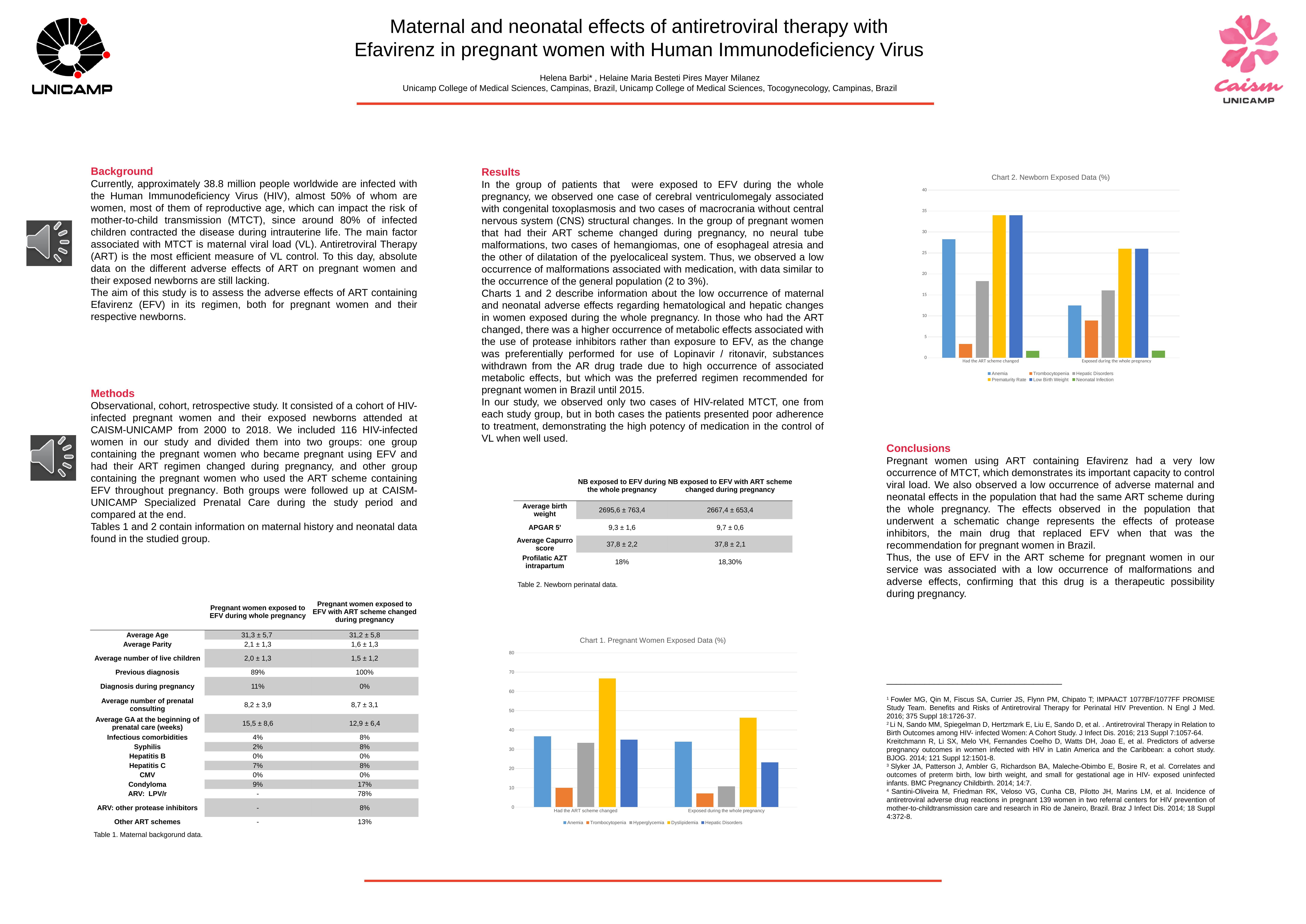
In Chart 1. Pregnant Women Exposed Data (%), which series has the lowest value for the 'Exposed during the whole pregnancy' group? Trombocytopenia In Chart 2. Newborn Exposed Data (%), which series has the lowest value for the 'Had the ART scheme changed' group? Neonatal Infection What is the title of the chart in the top right of the slide? Chart 2. Newborn Exposed Data (%) What kind of chart is Chart 1. Pregnant Women Exposed Data (%)? bar chart How many series does the legend of Chart 2. Newborn Exposed Data (%) list? 6 How many series does the legend of Chart 1. Pregnant Women Exposed Data (%) list? 5 How many categories are shown on the x axis of Chart 2. Newborn Exposed Data (%)? 2 In Chart 1. Pregnant Women Exposed Data (%), is the Hyperglycemia value for 'Exposed during the whole pregnancy' greater or less than 20? less In Chart 2. Newborn Exposed Data (%), which group has the larger Prematurity Rate value: 'Had the ART scheme changed' or 'Exposed during the whole pregnancy'? Had the ART scheme changed In Chart 2. Newborn Exposed Data (%), is the Anemia value for 'Had the ART scheme changed' greater or less than 25? greater In Chart 1. Pregnant Women Exposed Data (%), which series has the highest value for the 'Had the ART scheme changed' group? Dyslipidemia In Chart 1. Pregnant Women Exposed Data (%), is the Dyslipidemia value for 'Had the ART scheme changed' greater or less than 60? greater